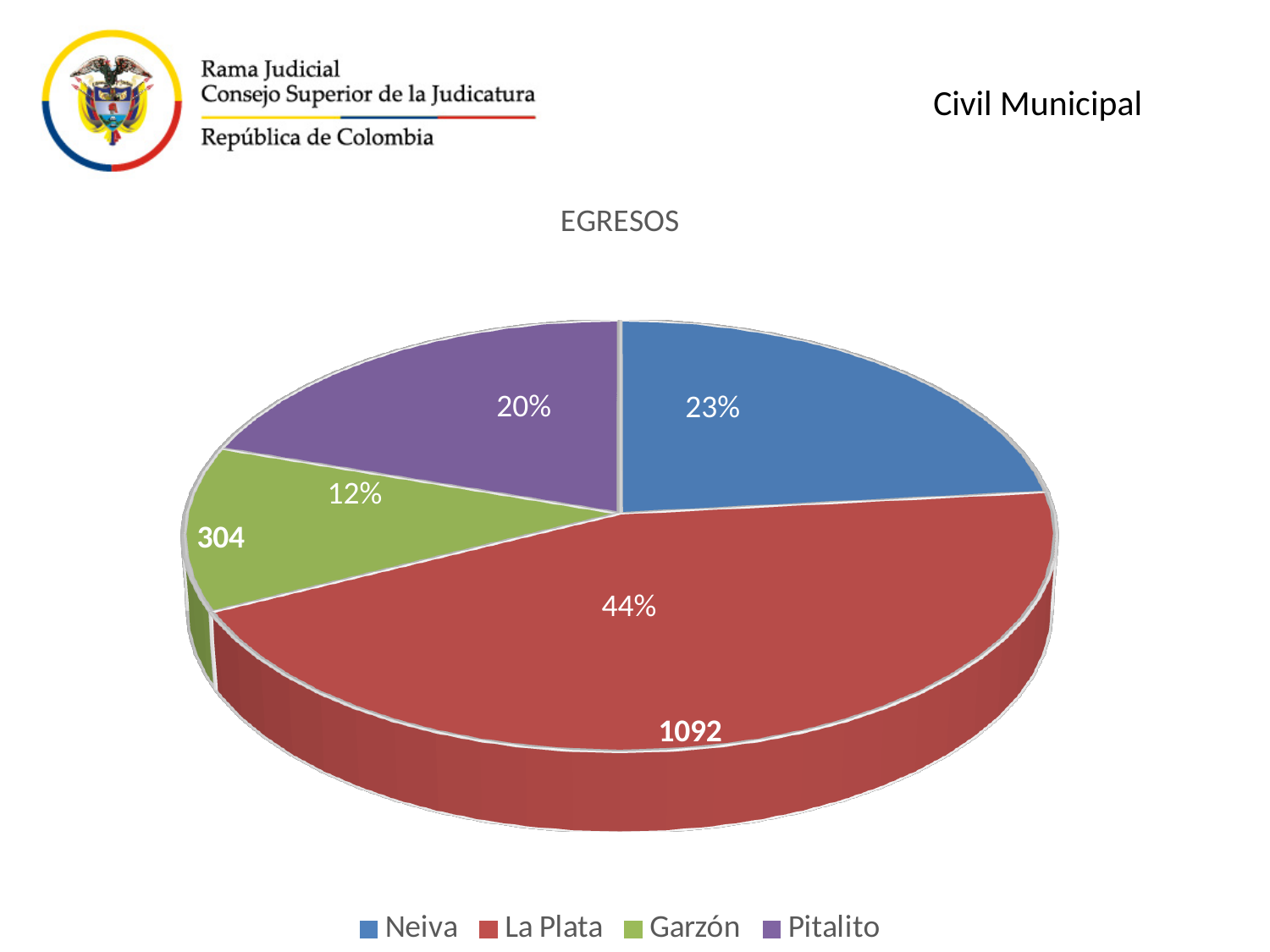
How many slices does the pie chart have? 4 What is the title of the chart? EGRESOS Which slice is larger, Neiva or Pitalito? Neiva What kind of chart is shown on the slide? Pie chart What share of the pie does Pitalito represent? 20% Which category has the smallest slice of the pie? Garzón Which category has the largest slice of the pie? La Plata Which colour represents Garzón in the legend? Green By how many percentage points does La Plata's share exceed Neiva's share? 21 percentage points What share of the pie does Garzón represent? 12% What share of the pie does La Plata represent? 44%